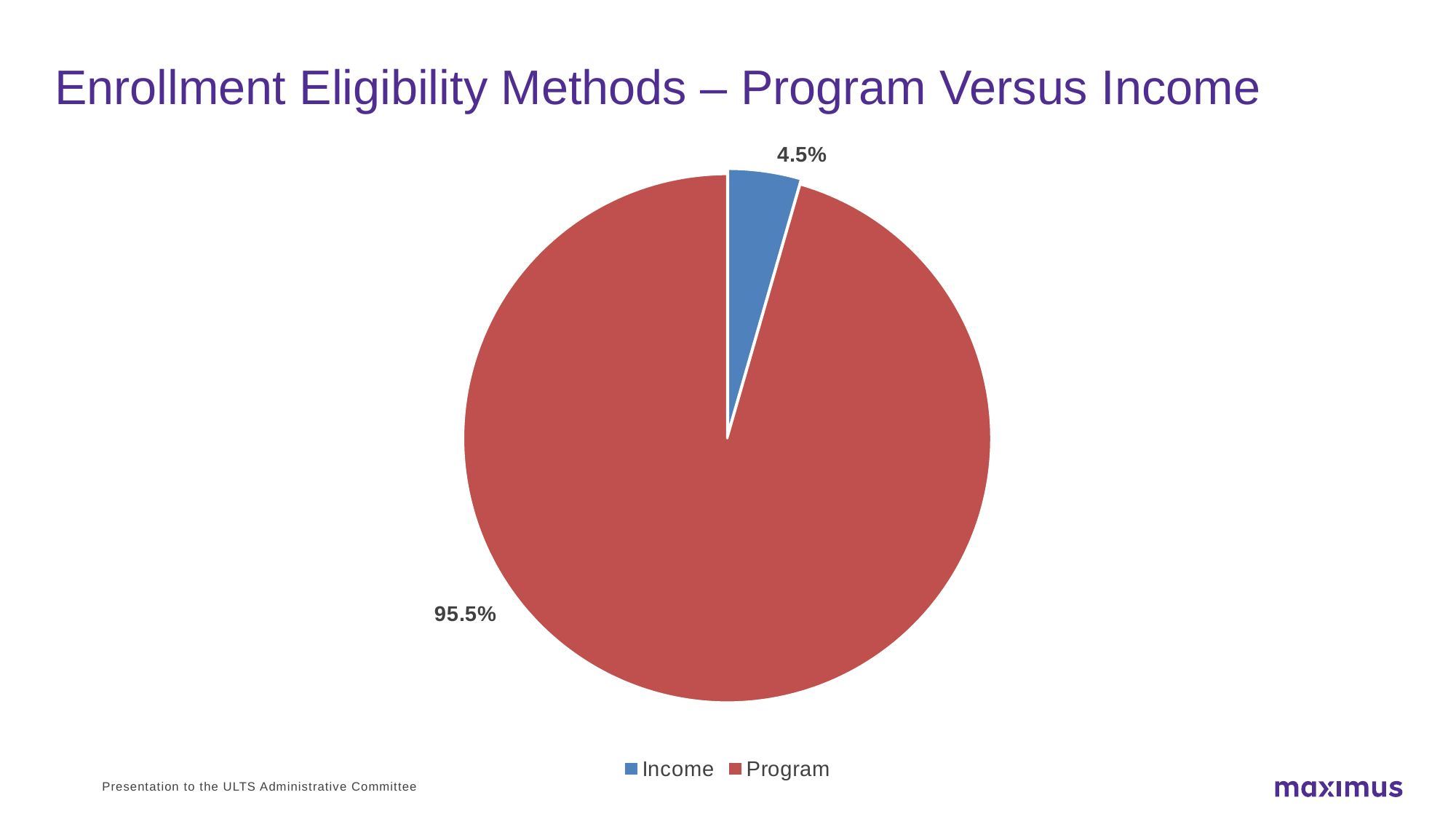
What share of the pie does Income account for? 4.5% What is the title of the slide containing the chart? Enrollment Eligibility Methods – Program Versus Income How many slices does the pie chart have? 2 Which is larger, the Income slice or the Program slice? Program What kind of chart is shown on the slide? Pie chart How many entries does the legend list? 2 Which category has the largest slice of the pie? Program What is the difference in percentage points between the Program and Income slices? 91 percentage points What share of the pie does Program account for? 95.5% What colour is the Program slice in the pie chart? Red Which category has the smallest slice of the pie? Income